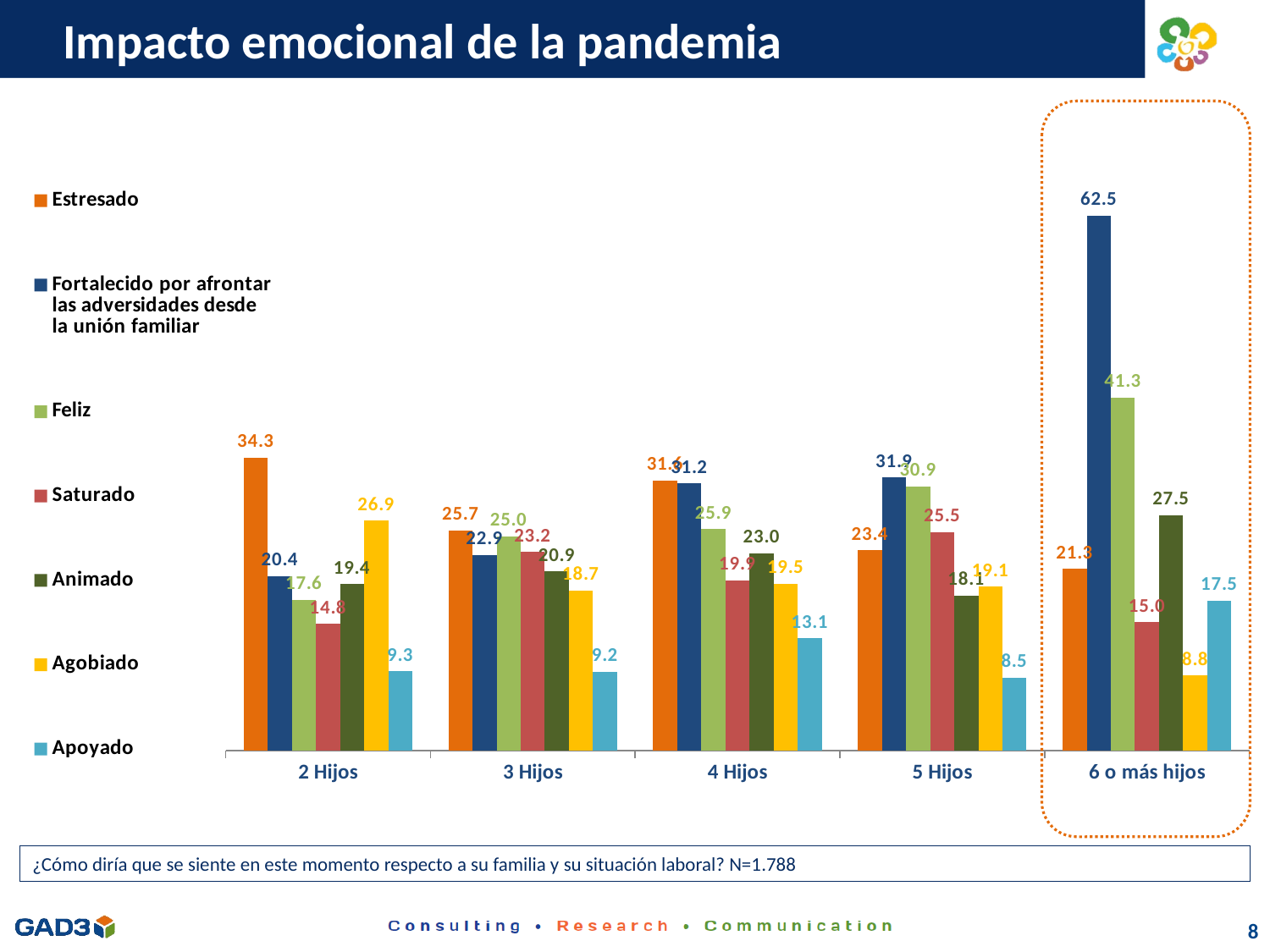
Which category has the lowest value for 'Apoyado'? 5 Hijos What is the value for 'Feliz' in the '5 Hijos' category? 30.9 What is the value for 'Estresado' in the '2 Hijos' category? 34.3 What kind of chart is shown on the slide? Bar chart Which category has the highest value for 'Fortalecido por afrontar las adversidades desde la unión familiar'? 6 o más hijos How many series does the legend list? 7 What is the value for 'Fortalecido por afrontar las adversidades desde la unión familiar' in the '6 o más hijos' category? 62.5 Do the values for 'Fortalecido por afrontar las adversidades desde la unión familiar' rise or fall from '2 Hijos' to '6 o más hijos'? Rise How many categories are shown on the x axis? 5 Which category is highlighted with a dotted outline on the chart? 6 o más hijos In the '6 o más hijos' category, what is the difference between the 'Fortalecido por afrontar las adversidades desde la unión familiar' value and the 'Feliz' value? 21.2 In the '2 Hijos' category, which is larger: 'Estresado' or 'Agobiado'? Estresado